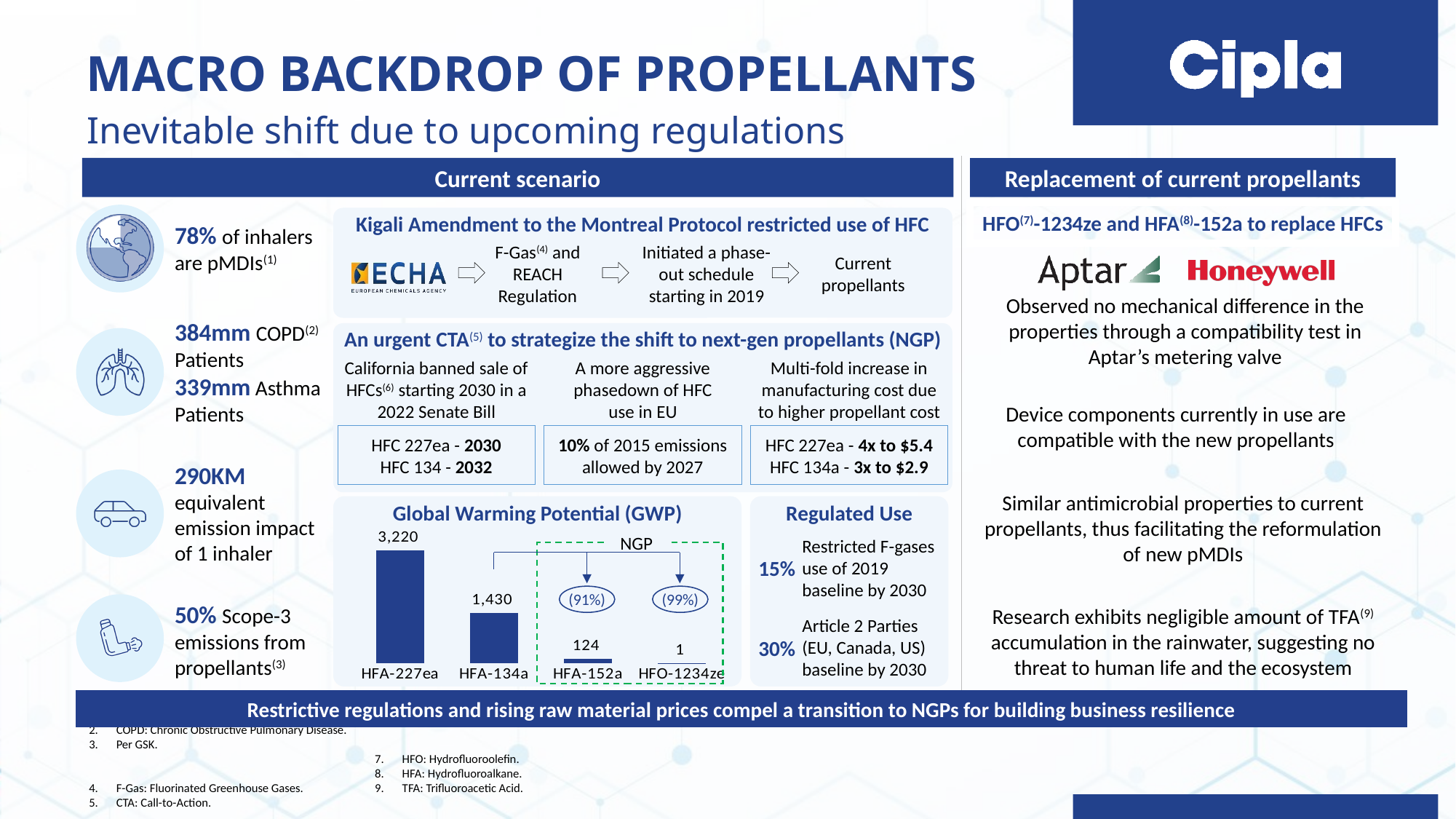
What is the GWP value shown for HFA-227ea in the Global Warming Potential chart? 3,220 In the Global Warming Potential chart, what percentage reduction is annotated above HFO-1234ze? (99%) Do the GWP values rise or fall from left to right across the Global Warming Potential chart? Fall Which propellant has the lowest GWP in the Global Warming Potential chart? HFO-1234ze What is the difference in GWP between HFA-227ea and HFA-134a in the Global Warming Potential chart? 1,790 What is the GWP value shown for HFA-134a in the Global Warming Potential chart? 1,430 How many propellants are plotted in the Global Warming Potential chart? 4 Which propellant has the highest GWP in the Global Warming Potential chart? HFA-227ea What is the GWP value shown for HFO-1234ze in the Global Warming Potential chart? 1 What type of chart is the Global Warming Potential (GWP) chart? Bar chart In the Global Warming Potential chart, which has a larger GWP, HFA-134a or HFA-152a? HFA-134a What is the GWP value shown for HFA-152a in the Global Warming Potential chart? 124